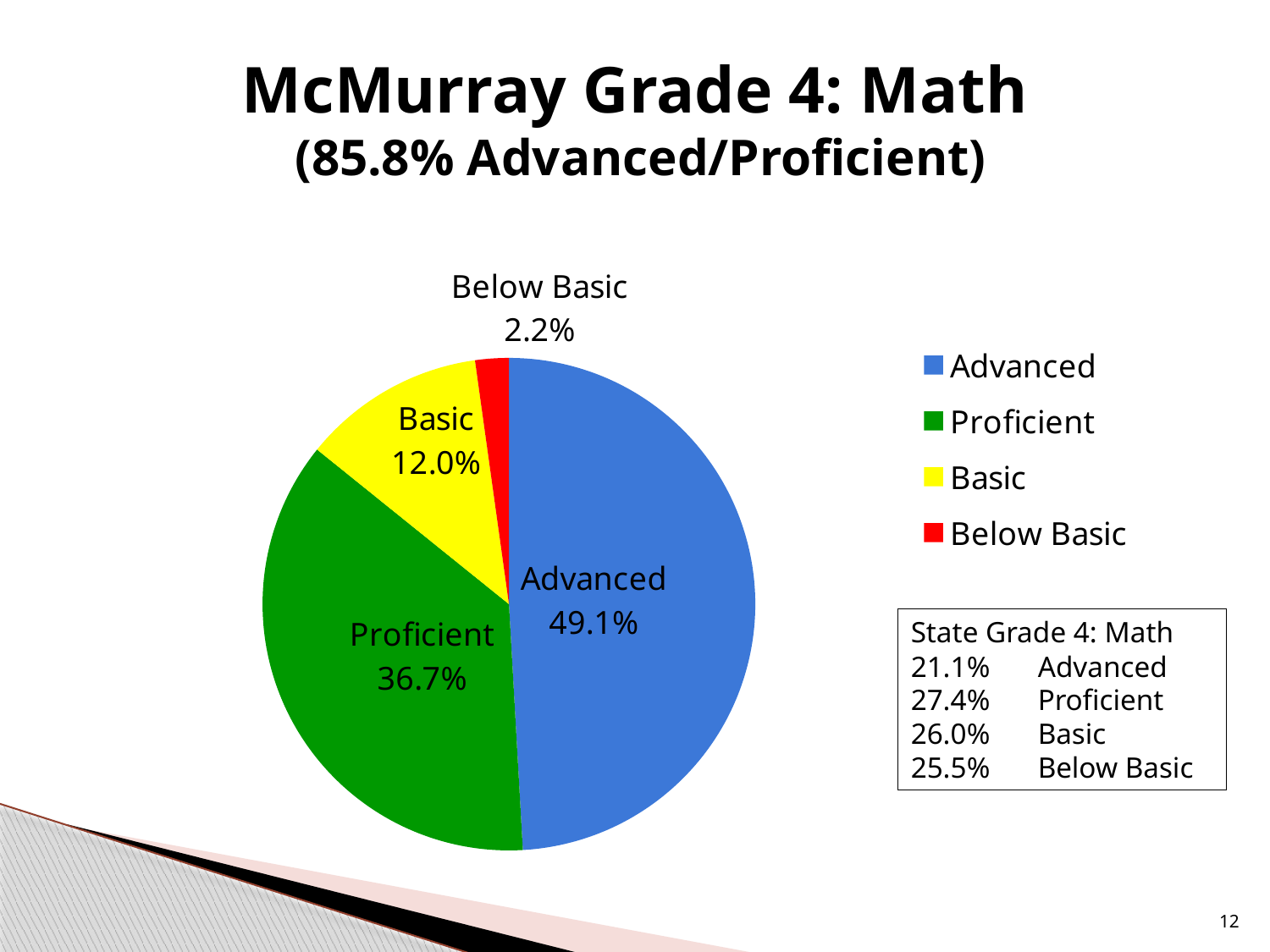
What colour is the Proficient slice in the pie chart? Green Which performance level has the largest share of the pie? Advanced Which slice is larger, Basic or Below Basic? Basic What is the combined share of the Advanced and Proficient slices? 85.8% Which performance level has the smallest share of the pie? Below Basic What percentage of students scored Proficient? 36.7% What percentage of students scored Basic? 12.0% How many slices does the pie chart have? 4 What kind of chart is shown on the slide? Pie chart What percentage of students scored Below Basic? 2.2% What percentage of McMurray Grade 4 students scored Advanced in Math? 49.1% What is the difference in percentage points between the Advanced and Proficient slices? 12.4